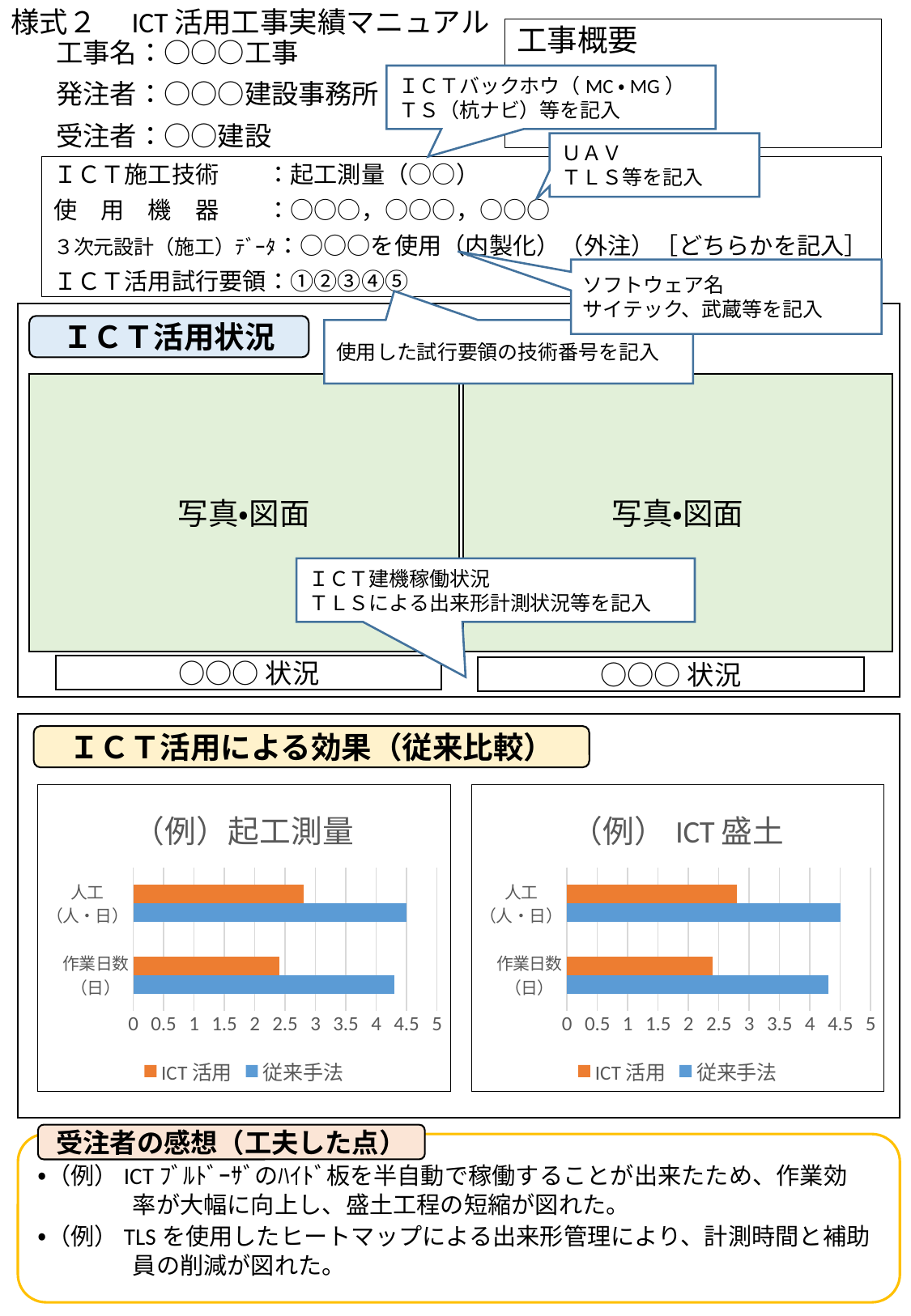
In the chart titled （例）起工測量, is the value of 従来手法 for 人工（人・日） greater or less than 4? greater In the chart titled （例）起工測量, which series is shown in orange? ICT活用 In the chart titled （例）ICT盛土, is the value of ICT活用 for 人工（人・日） greater or less than 3.5? less In the chart titled （例）ICT盛土, how many series does the legend list? 2 In the chart titled （例）起工測量, how many categories are shown on the vertical axis? 2 In the chart titled （例）ICT盛土, which series has the larger value for 作業日数（日）: ICT活用 or 従来手法? 従来手法 What kind of chart is the chart titled （例）起工測量? bar chart In the chart titled （例）起工測量, which series has the larger value for 人工（人・日）: ICT活用 or 従来手法? 従来手法 In the chart titled （例）起工測量, is the value of ICT活用 for 作業日数（日） greater or less than 3? less What is the title of the right-hand chart in the ICT活用による効果（従来比較） section? （例）ICT盛土